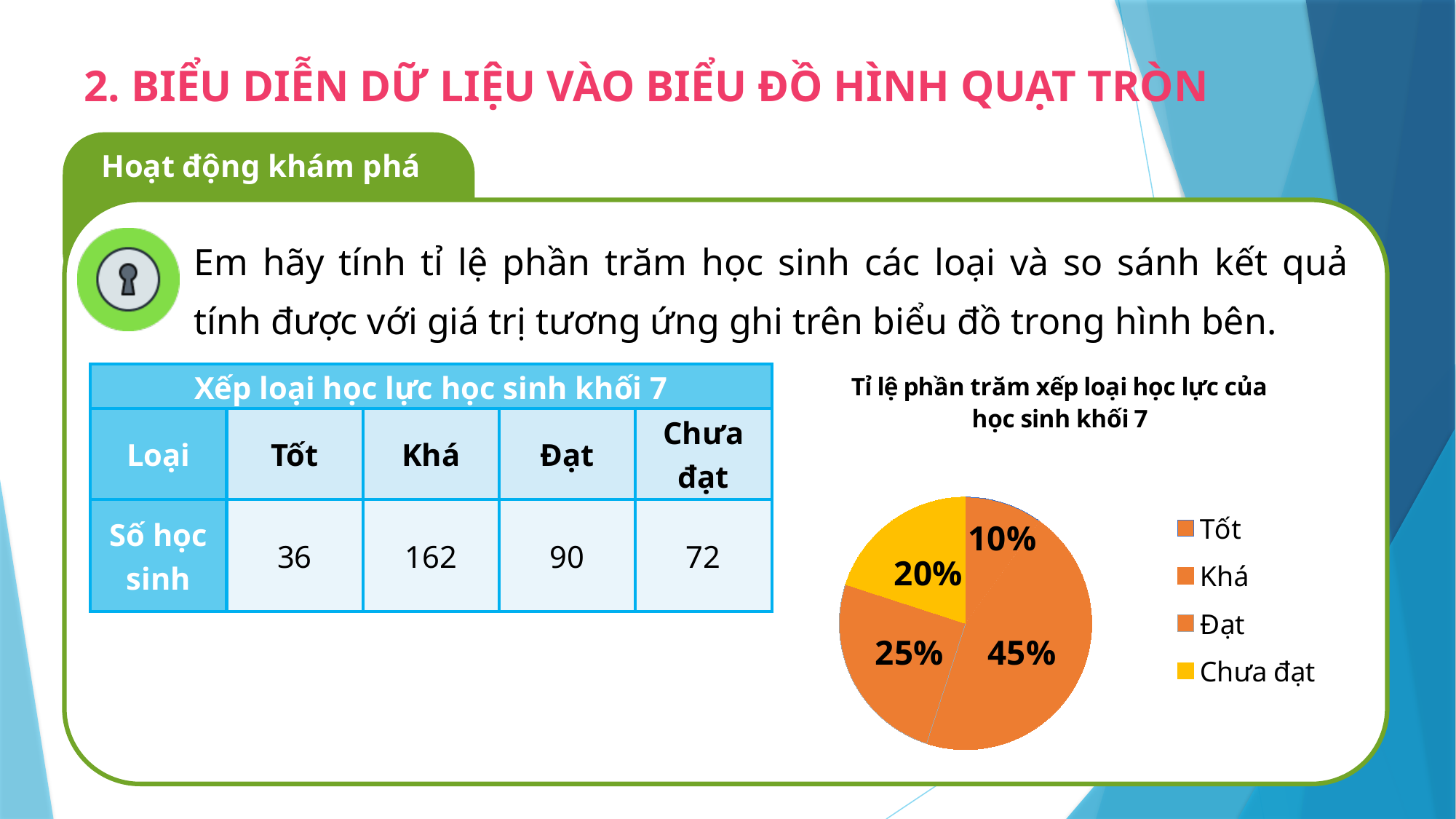
What kind of chart is shown on the slide? pie chart What percentage is shown for Chưa đạt in the pie chart? 20% What is the difference in percentage points between the Khá slice and the Đạt slice? 20 Which slice is larger, Đạt or Chưa đạt? Đạt What percentage is shown for Khá in the pie chart? 45% Which colour is used for the Chưa đạt slice in the pie chart? yellow What percentage is shown for Tốt in the pie chart? 10% What percentage is shown for Đạt in the pie chart? 25% What is the chart's title? Tỉ lệ phần trăm xếp loại học lực của học sinh khối 7 How many categories does the legend of the pie chart list? 4 Which category has the largest slice of the pie chart? Khá Which category has the smallest slice of the pie chart? Tốt